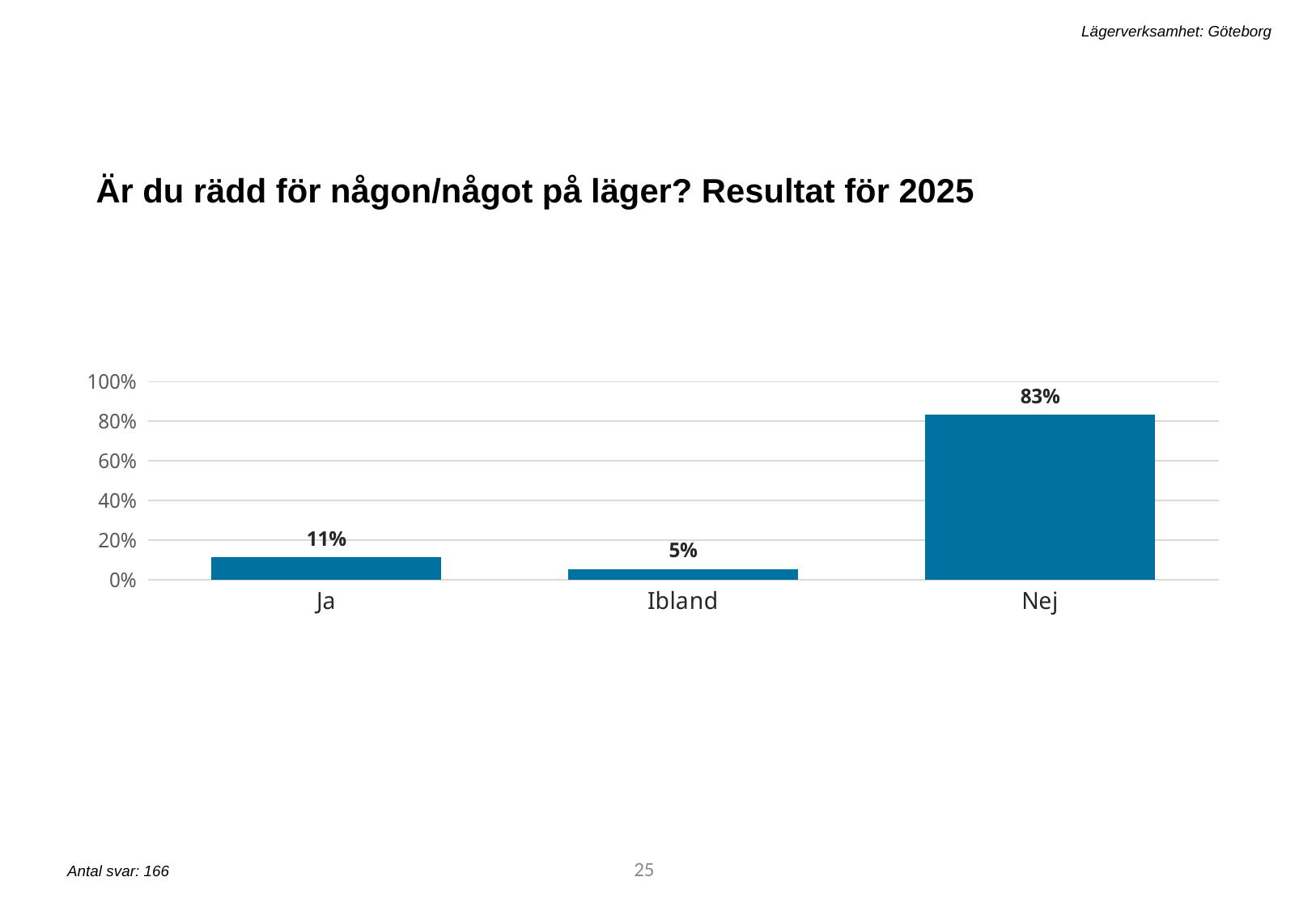
Which is larger, the value for Ja or the value for Ibland? Ja Which category has the highest value? Nej What kind of chart is shown on the slide? bar chart How many categories are shown on the x axis? 3 What is the value for Nej? 83% What is the difference between the values for Ja and Ibland? 6% What is the title of the chart? Är du rädd för någon/något på läger? Resultat för 2025 What is the value for Ja? 11% Which category has the lowest value? Ibland Is the value for Nej greater or less than 80%? greater What is the value for Ibland? 5% What is the difference between the values for Nej and Ja? 72%